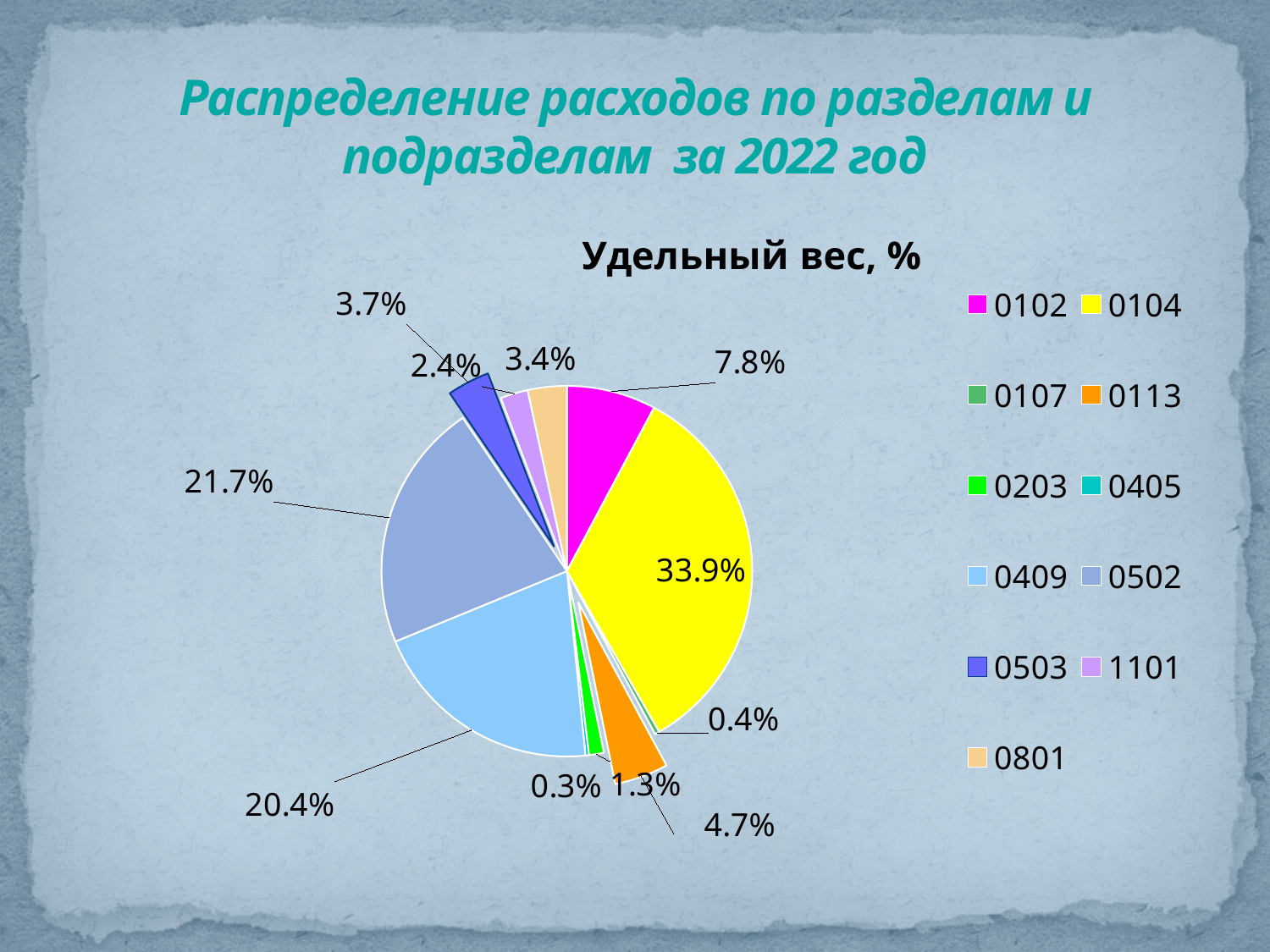
What type of chart is shown on the slide? Pie chart What share does category 0503 have in the pie chart? 3.7% Which has the larger share, 0502 or 0409? 0502 By how many percentage points does the share of 0104 exceed the share of 0102? 26.1 What share does category 0104 have in the pie chart? 33.9% What is the smallest percentage shown on the pie chart? 0.3% What share does category 0502 have in the pie chart? 21.7% What share does category 0409 have in the pie chart? 20.4% How many categories does the legend of the pie chart list? 11 What share does category 0102 have in the pie chart? 7.8% What share does category 0113 have in the pie chart? 4.7% Which category has the largest slice of the pie chart? 0104